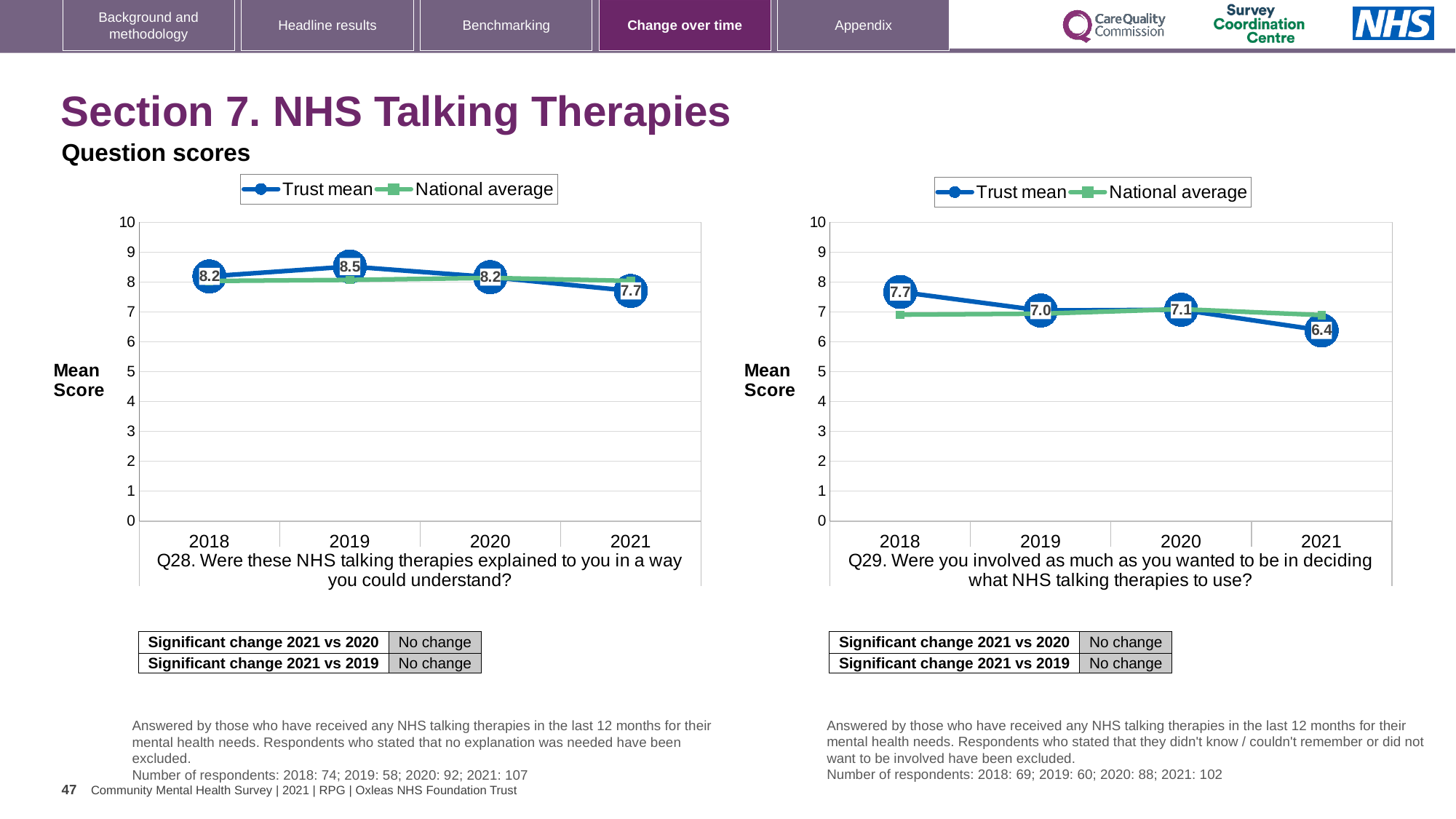
In the Q28 chart (left), what is the Trust mean score for 2021? 7.7 In the Q28 chart (left), what is the Trust mean score for 2019? 8.5 In the Q28 chart (left), how many years are shown on the x axis? 4 In the Q29 chart (right), what is the difference between the Trust mean scores for 2018 and 2021? 1.3 In the Q29 chart (right), is the Trust mean score for 2018 greater or less than 7? greater In the Q29 chart (right), how many series does the legend list? 2 What type of chart is used for Q28 (left)? Line chart In the Q28 chart (left), what is the difference between the Trust mean scores for 2019 and 2021? 0.8 In the Q28 chart (left), which year has the highest Trust mean score? 2019 In the Q29 chart (right), what is the Trust mean score for 2021? 6.4 In the Q29 chart (right), what is the Trust mean score for 2018? 7.7 In the Q29 chart (right), which year has the lowest Trust mean score? 2021